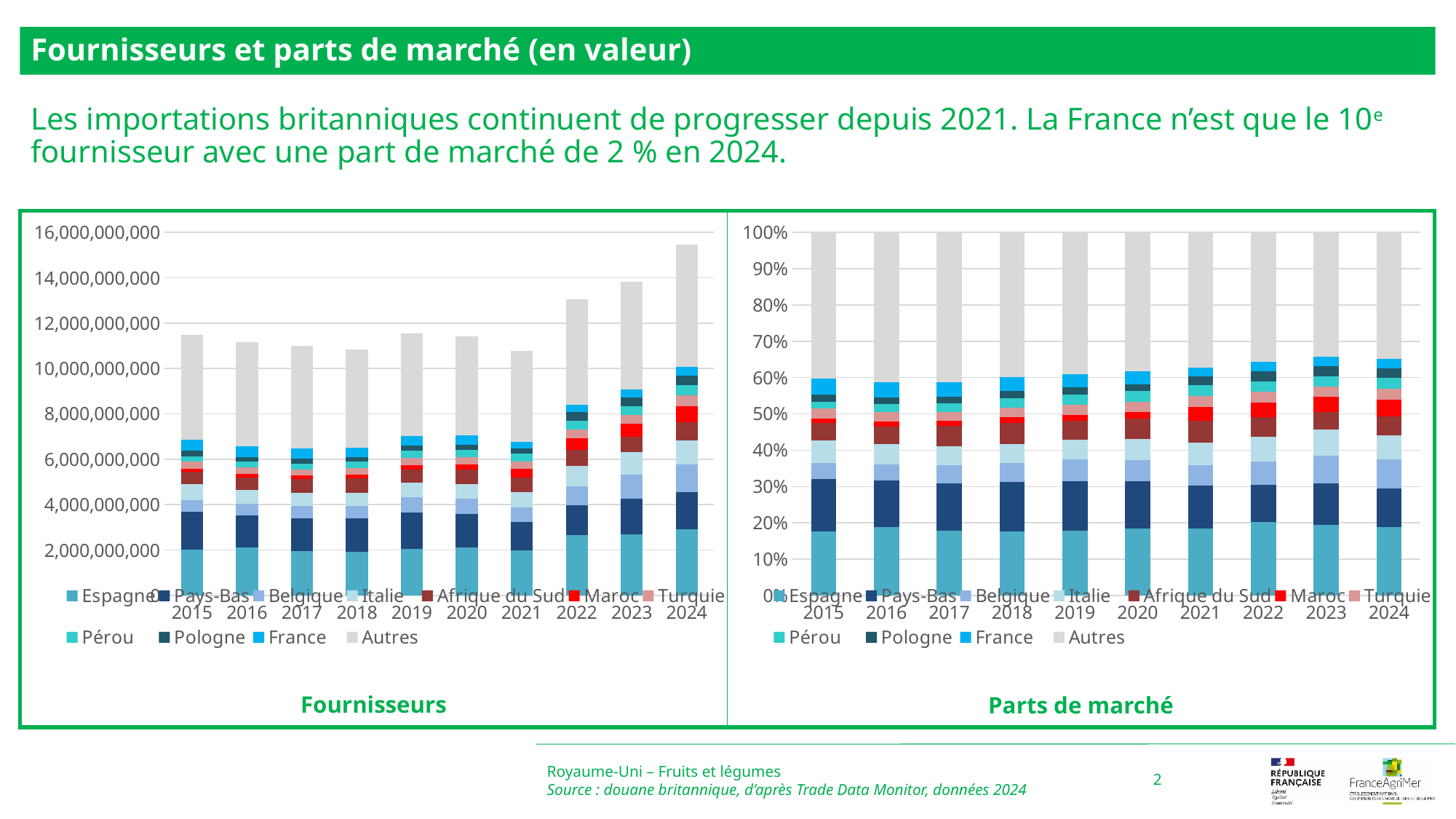
In the 'Fournisseurs' chart, do the total bars rise or fall from 2021 to 2024? rise In the 'Fournisseurs' chart, is the total for 2021 greater or less than 12,000,000,000? less In the 'Fournisseurs' chart, is the total for 2024 greater or less than 14,000,000,000? greater In the 'Parts de marché' chart, is the Espagne share in 2015 greater or less than 20%? less In the 'Fournisseurs' chart, which year has the highest total bar? 2024 How many years are shown on the x axis of the 'Fournisseurs' chart? 10 In the 'Fournisseurs' chart, is the total bar for 2024 larger or smaller than the total bar for 2023? larger How many series does the legend of the 'Parts de marché' chart list? 11 What kind of chart is the 'Fournisseurs' chart on the left? Stacked bar chart Which legend entry in the 'Parts de marché' chart is shown in light grey? Autres